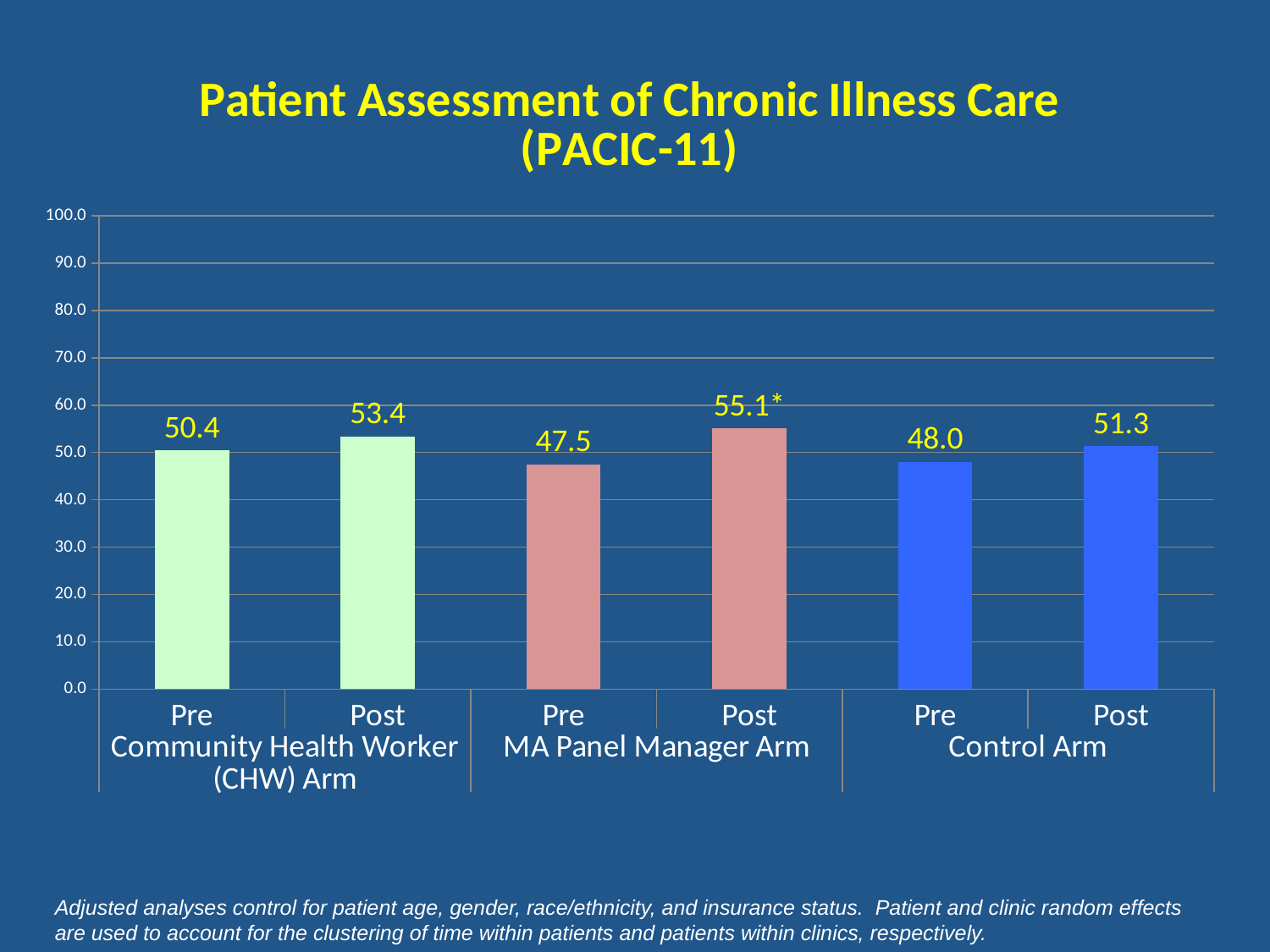
How many bars are plotted on the chart? 6 Which bar has the highest value on the chart? Post, MA Panel Manager Arm What kind of chart is shown on the slide? Bar chart Which is larger: the Post value for the Control Arm or the Post value for the Community Health Worker (CHW) Arm? Post value for the Community Health Worker (CHW) Arm What is the Post value for the MA Panel Manager Arm? 55.1* Is the Post value for the MA Panel Manager Arm greater or less than 50.0? greater Which bar has the lowest value on the chart? Pre, MA Panel Manager Arm What is the Pre value for the Community Health Worker (CHW) Arm? 50.4 What is the difference between the Post and Pre values for the MA Panel Manager Arm? 7.6 What is the title of the chart? Patient Assessment of Chronic Illness Care (PACIC-11) What is the difference between the Post and Pre values for the Community Health Worker (CHW) Arm? 3.0 What is the Pre value for the Control Arm? 48.0